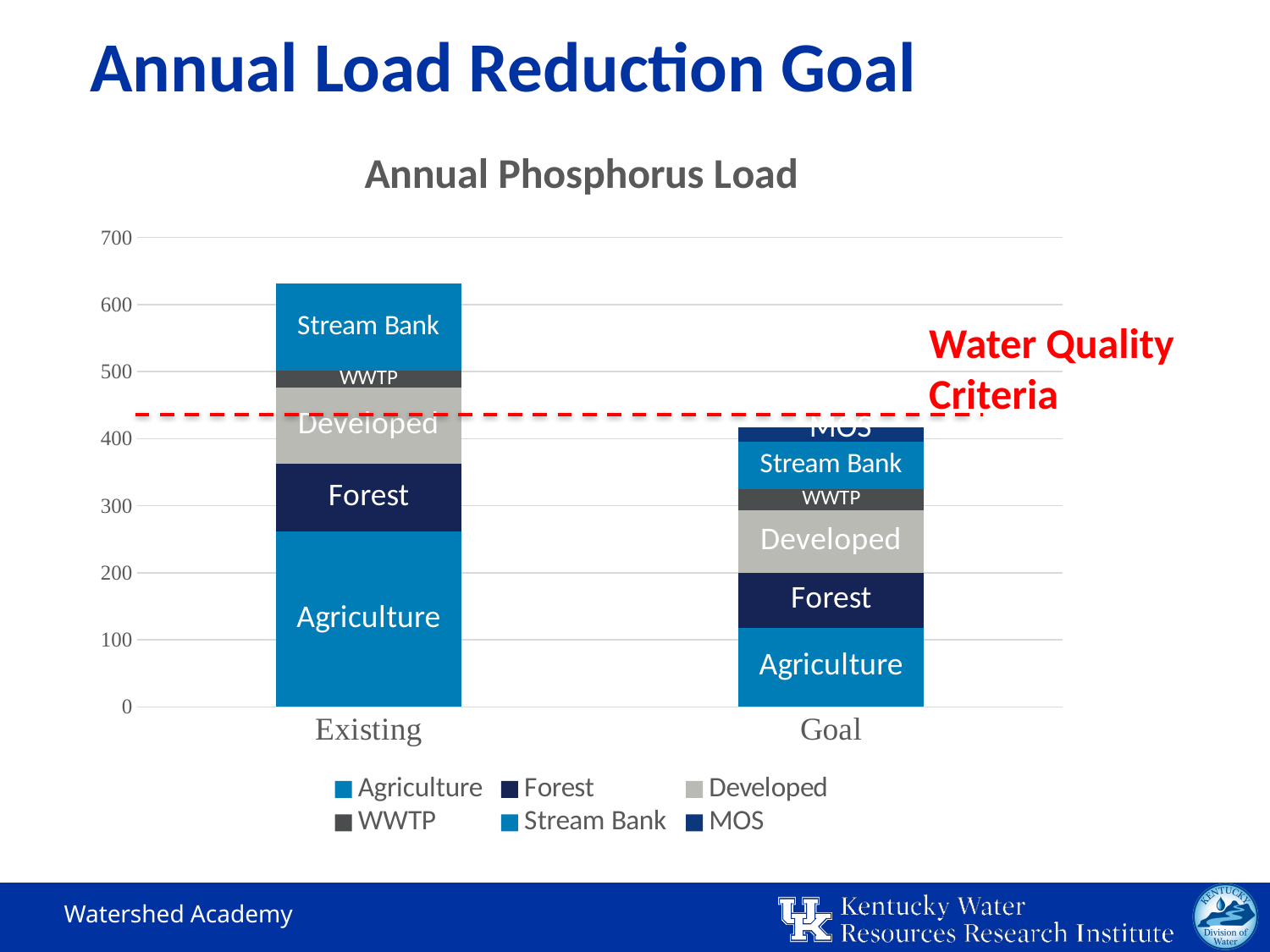
Is the Agriculture segment in the Goal bar greater or less than 200? less What kind of chart is shown on the slide? Stacked bar chart Which category has the higher total annual phosphorus load, Existing or Goal? Existing What is the title of the chart? Annual Phosphorus Load Which bar has the larger Agriculture segment, Existing or Goal? Existing Is the total value for the Goal bar greater or less than 500? less Which category has the lowest total bar? Goal Is the total value for the Existing bar greater or less than 600? greater How many series does the legend list? 6 What does the red dashed horizontal line on the chart represent? Water Quality Criteria How many categories are shown on the x axis? 2